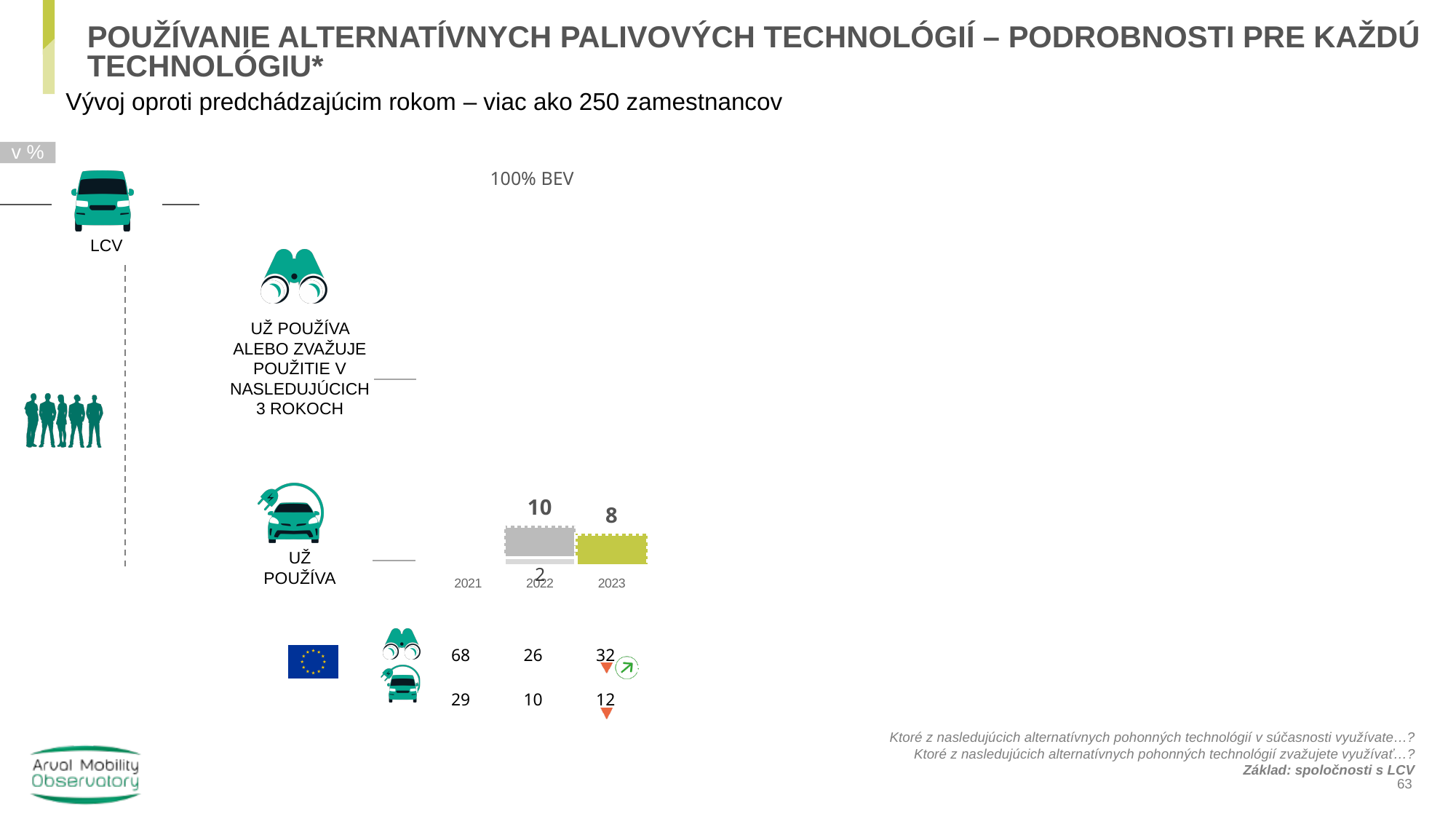
In the '100% BEV' bar chart for 'UŽ POUŽÍVA', what is the value for 2023? 8 In the '100% BEV' bar chart for 'UŽ POUŽÍVA', which is larger, the value for 2022 or for 2023? 2022 In the '100% BEV' bar chart for 'UŽ POUŽÍVA', does the value rise or fall from 2022 to 2023? fall In the '100% BEV' bar chart for 'UŽ POUŽÍVA', what is the value for 2022? 10 What kind of chart is used for 'UŽ POUŽÍVA' under '100% BEV'? bar chart In the '100% BEV' bar chart for 'UŽ POUŽÍVA', what is the difference between the 2022 and 2023 values? 2 What technology label is shown above the 'UŽ POUŽÍVA' bar chart? 100% BEV How many years are shown in the '100% BEV' bar chart for 'UŽ POUŽÍVA'? 3 In the '100% BEV' bar chart for 'UŽ POUŽÍVA', which year has the highest value? 2022 In the '100% BEV' bar chart for 'UŽ POUŽÍVA', which year has the lowest value? 2021